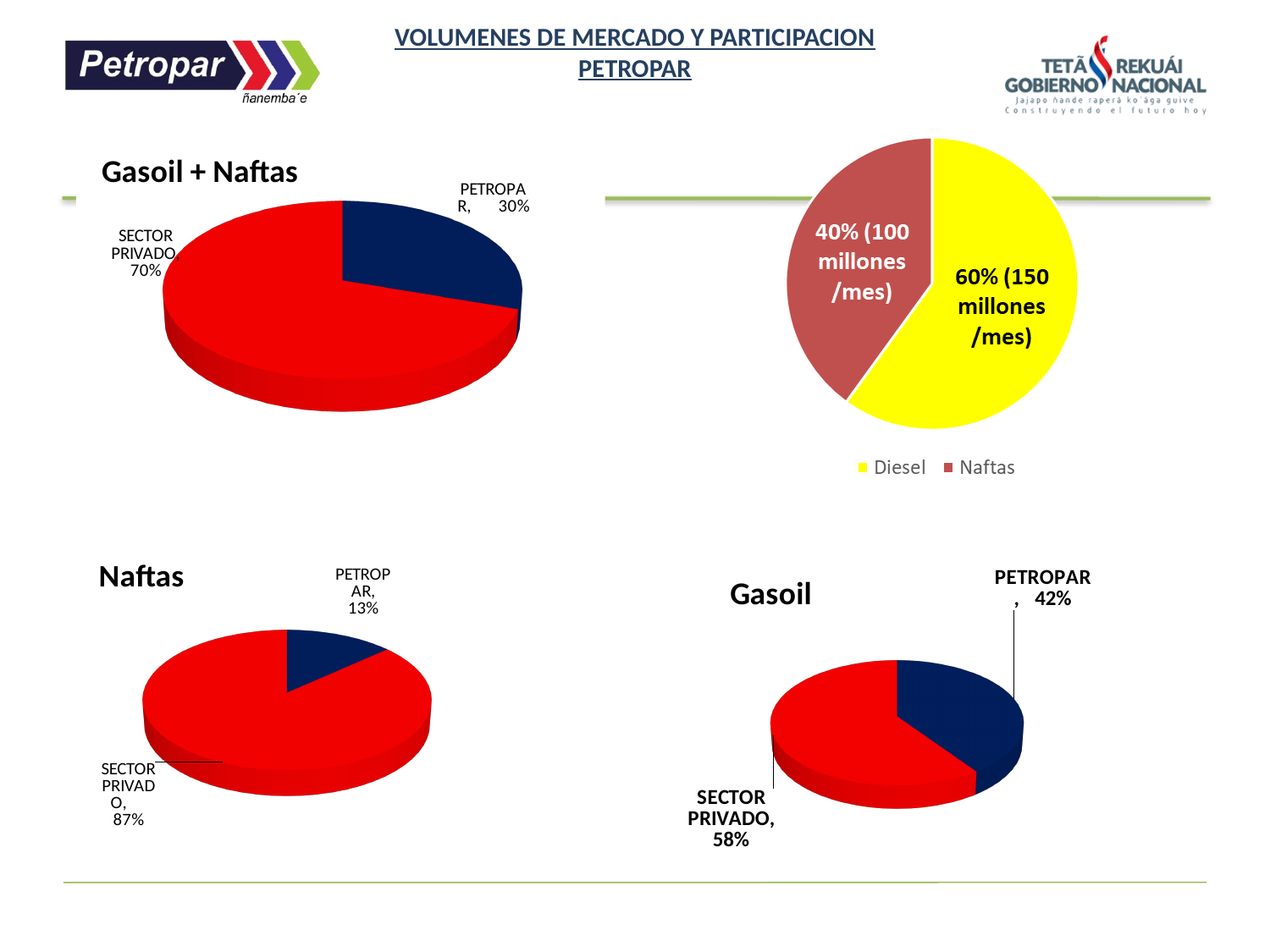
In the 'Gasoil' chart, what is the difference between the SECTOR PRIVADO share and the PETROPAR share? 16% How many series does the legend of the top-right pie chart list? 2 What kind of chart is the 'Gasoil' chart? Pie chart In the top-right pie chart, which colour represents Diesel? Yellow In the 'Naftas' chart, what is the difference between the SECTOR PRIVADO share and the PETROPAR share? 74% In the 'Gasoil' chart, which slice is larger, PETROPAR or SECTOR PRIVADO? SECTOR PRIVADO In the top-right pie chart, what share does Naftas hold? 40% (100 millones/mes) In the 'Naftas' chart, what share does PETROPAR hold? 13% In the 'Gasoil' chart, what share does SECTOR PRIVADO hold? 58% In the 'Gasoil + Naftas' chart, what share does PETROPAR hold? 30% In the 'Gasoil + Naftas' chart, what share does SECTOR PRIVADO hold? 70% In the top-right pie chart, what share does Diesel hold? 60% (150 millones/mes)